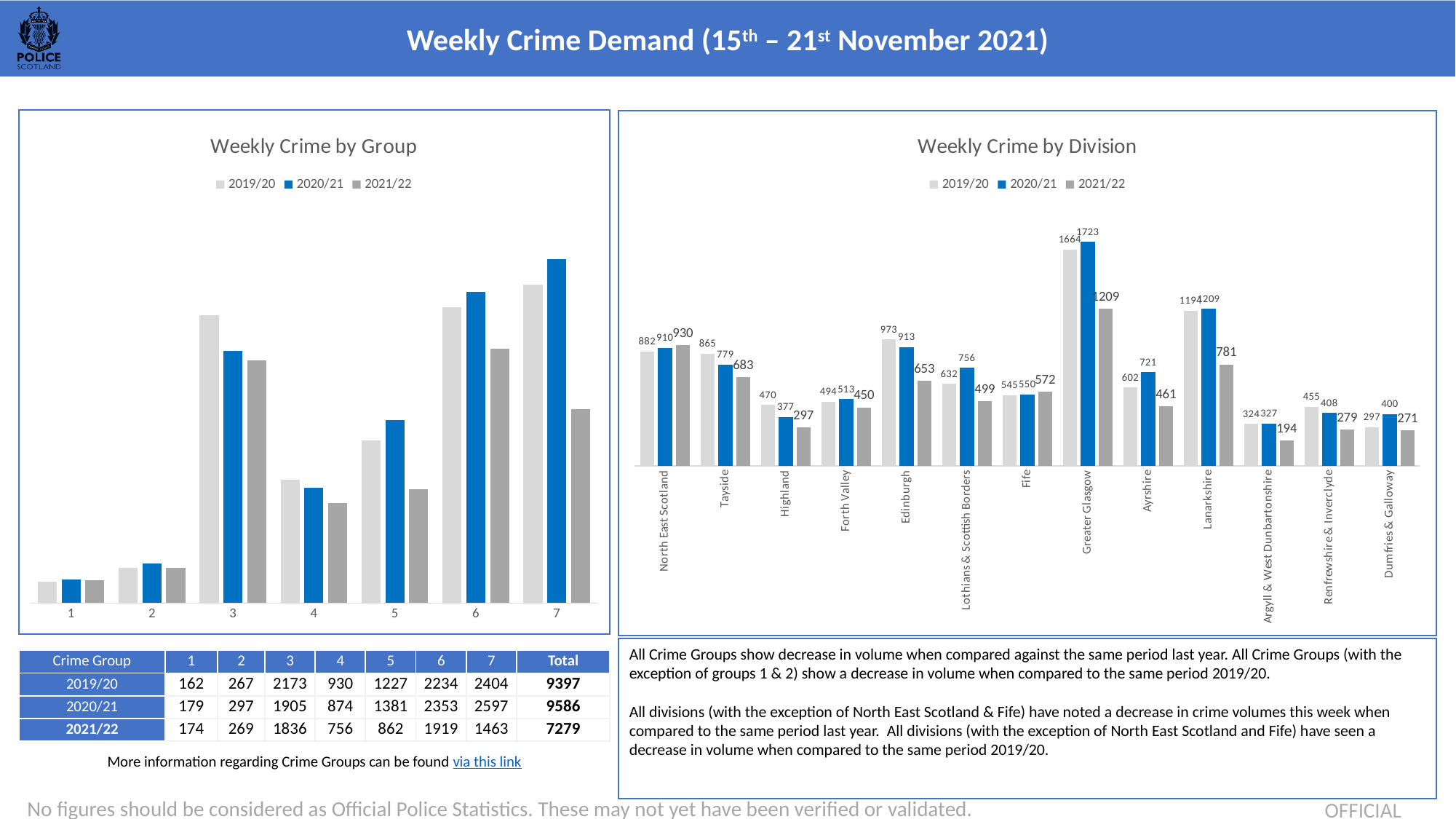
In the 'Weekly Crime by Division' chart, which has the larger 2019/20 value, Edinburgh or Tayside? Edinburgh In the 'Weekly Crime by Division' chart, which division has the lowest 2021/22 value? Argyll & West Dunbartonshire In the 'Weekly Crime by Group' chart, which crime group has the highest 2020/21 value? 7 In the 'Weekly Crime by Division' chart, what is the 2020/21 value for Highland? 377 In the 'Weekly Crime by Division' chart, which division has the highest 2021/22 value? Greater Glasgow How many crime groups are shown on the x axis of the 'Weekly Crime by Group' chart? 7 According to the table below the 'Weekly Crime by Group' chart, what is the 2021/22 value for crime group 3? 1836 How many series does the legend of the 'Weekly Crime by Division' chart list? 3 What kind of chart is the 'Weekly Crime by Division' chart? bar chart In the 'Weekly Crime by Division' chart, what is the difference between the 2020/21 and 2021/22 values for Greater Glasgow? 514 In the 'Weekly Crime by Division' chart, what is the 2021/22 value for Greater Glasgow? 1209 How many divisions are shown on the x axis of the 'Weekly Crime by Division' chart? 13